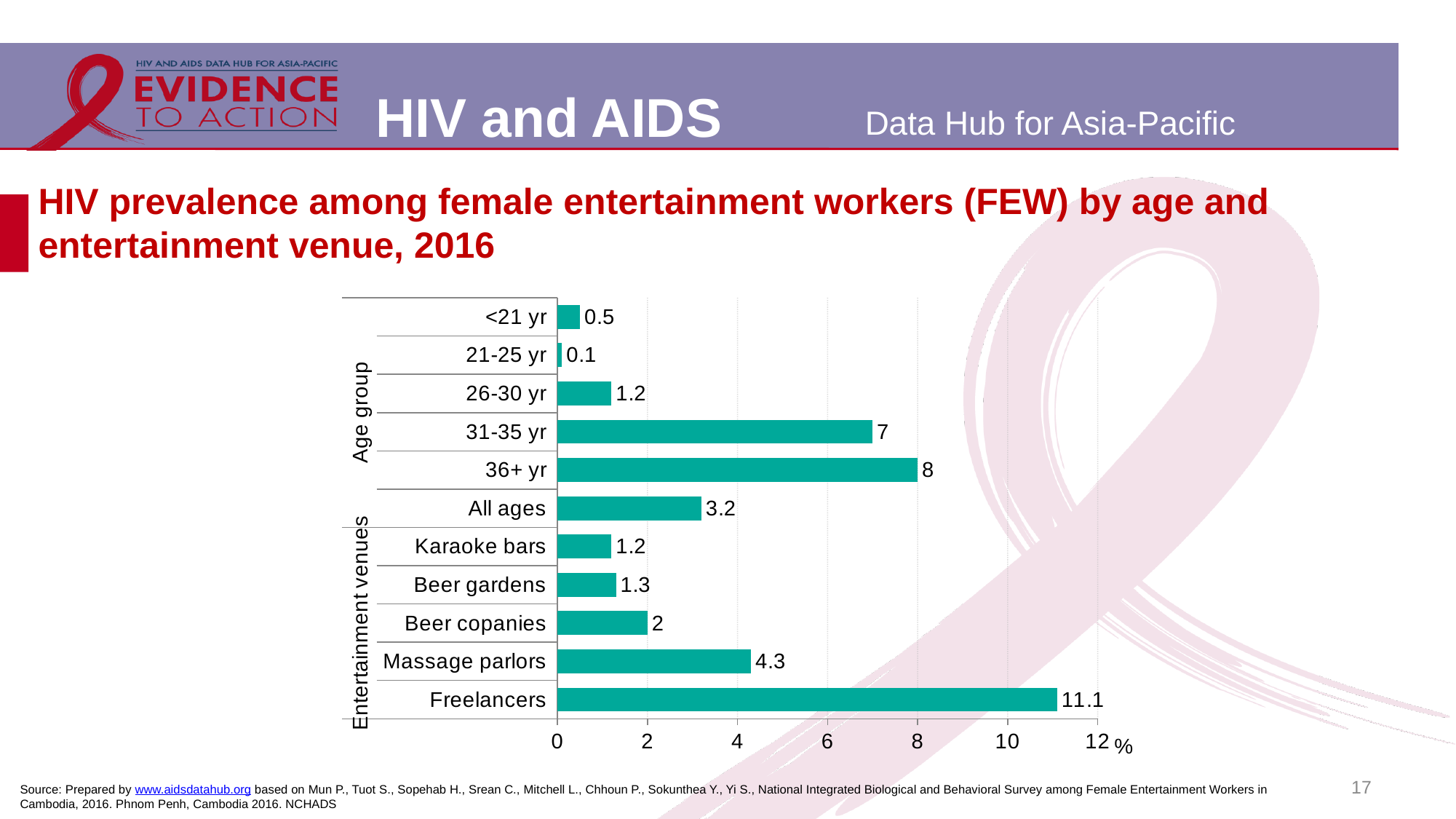
Which age group has the lowest HIV prevalence? 21-25 yr What is the HIV prevalence for Freelancers? 11.1 What is the difference in HIV prevalence between Freelancers and Massage parlors? 6.8 What is the HIV prevalence for All ages? 3.2 What is the HIV prevalence among female entertainment workers aged 36+ yr? 8 What kind of chart is shown on the slide? Bar chart How many categories are plotted on the chart? 11 What is the HIV prevalence for Massage parlors? 4.3 What is the HIV prevalence for the 21-25 yr age group? 0.1 What unit is shown at the end of the x axis? % Which category has the highest HIV prevalence on the chart? Freelancers Which has a higher HIV prevalence, the 31-35 yr group or the 36+ yr group? 36+ yr